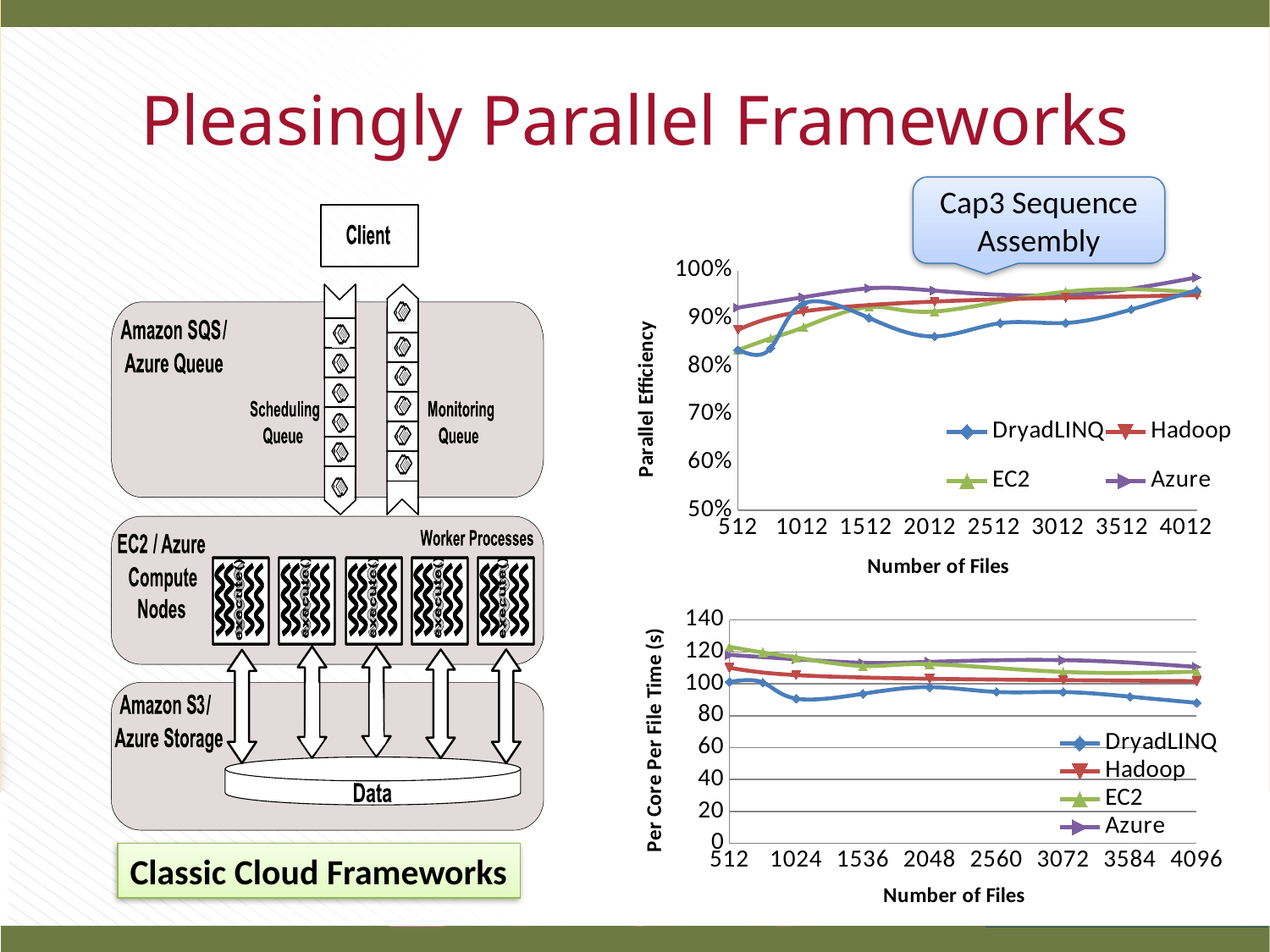
In the Per Core Per File Time (s) chart, which series has the lowest value at 4096 files? DryadLINQ In the Parallel Efficiency chart, does the Hadoop line overall rise or fall from 512 to 4012 files? rise In the Parallel Efficiency chart, is the value for Azure at 4012 files greater or less than 90%? greater In the Parallel Efficiency chart, which series has the highest value at 512 files? Azure What is the x-axis title of the Parallel Efficiency chart? Number of Files In the Per Core Per File Time (s) chart, is the value for Hadoop at 512 files greater or less than 100? greater What kind of chart is the bottom chart with the y axis labelled Per Core Per File Time (s)? line chart How many series does the legend of the Parallel Efficiency chart list? 4 What kind of chart is the top chart with the y axis labelled Parallel Efficiency? line chart In the Per Core Per File Time (s) chart, is the value for DryadLINQ at 4096 files greater or less than 100? less In the Per Core Per File Time (s) chart, which is larger at 512 files, EC2 or DryadLINQ? EC2